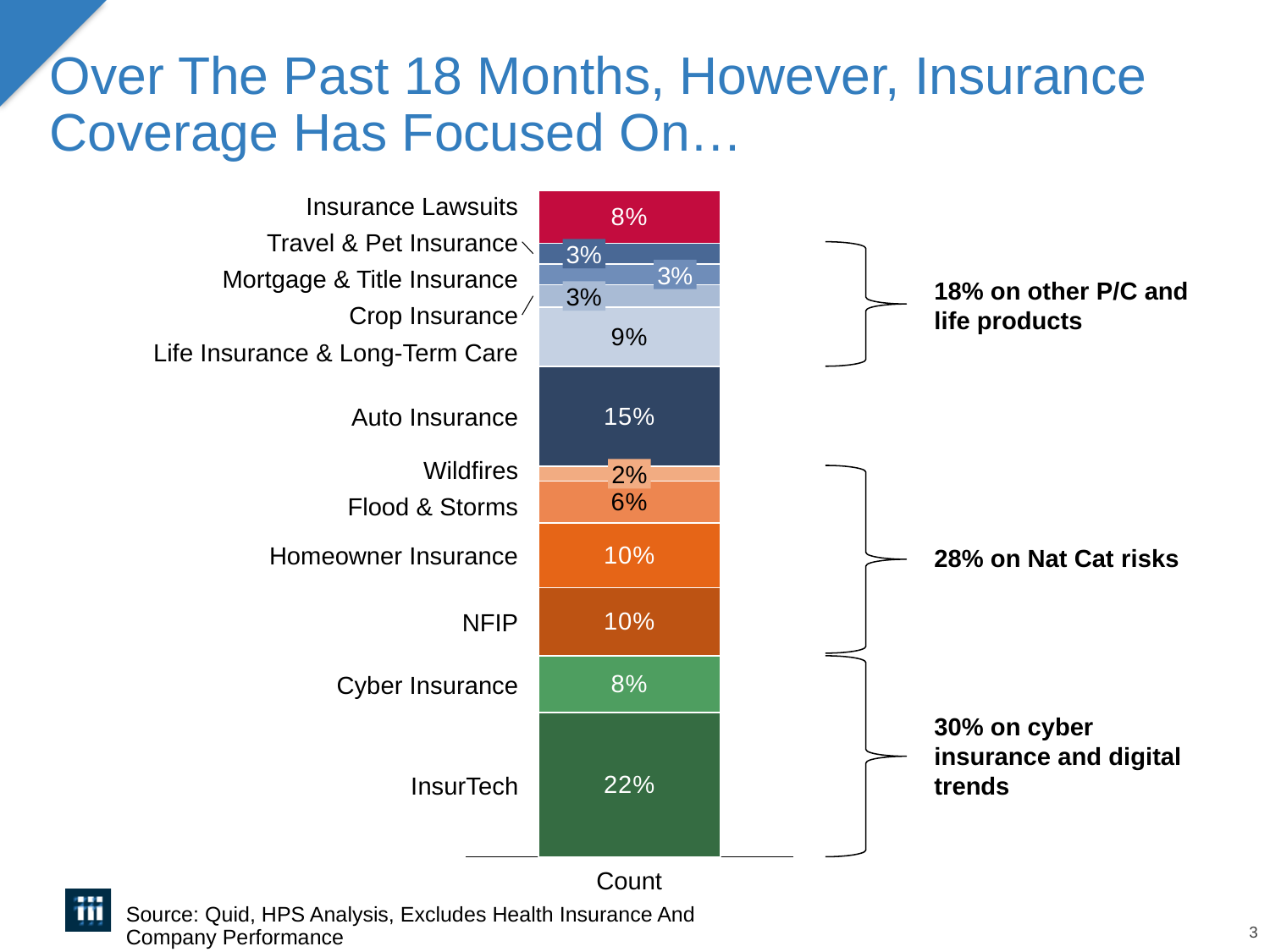
What percentage of insurance coverage is attributed to InsurTech? 22% What is the difference between the InsurTech value and the Auto Insurance value? 7% Which category has the smallest segment in the stacked bar? Wildfires How many categories are stacked in the bar? 12 What kind of chart is shown on the slide? Stacked bar chart Which category has the largest segment in the stacked bar? InsurTech Which is larger, the value for Auto Insurance or the value for Homeowner Insurance? Auto Insurance What is the label on the horizontal axis below the bar? Count According to the annotation on the right, what share of coverage is on Nat Cat risks? 28% What is the value for Flood & Storms? 6% What is the value shown for Auto Insurance? 15% What percentage is shown for Life Insurance & Long-Term Care? 9%